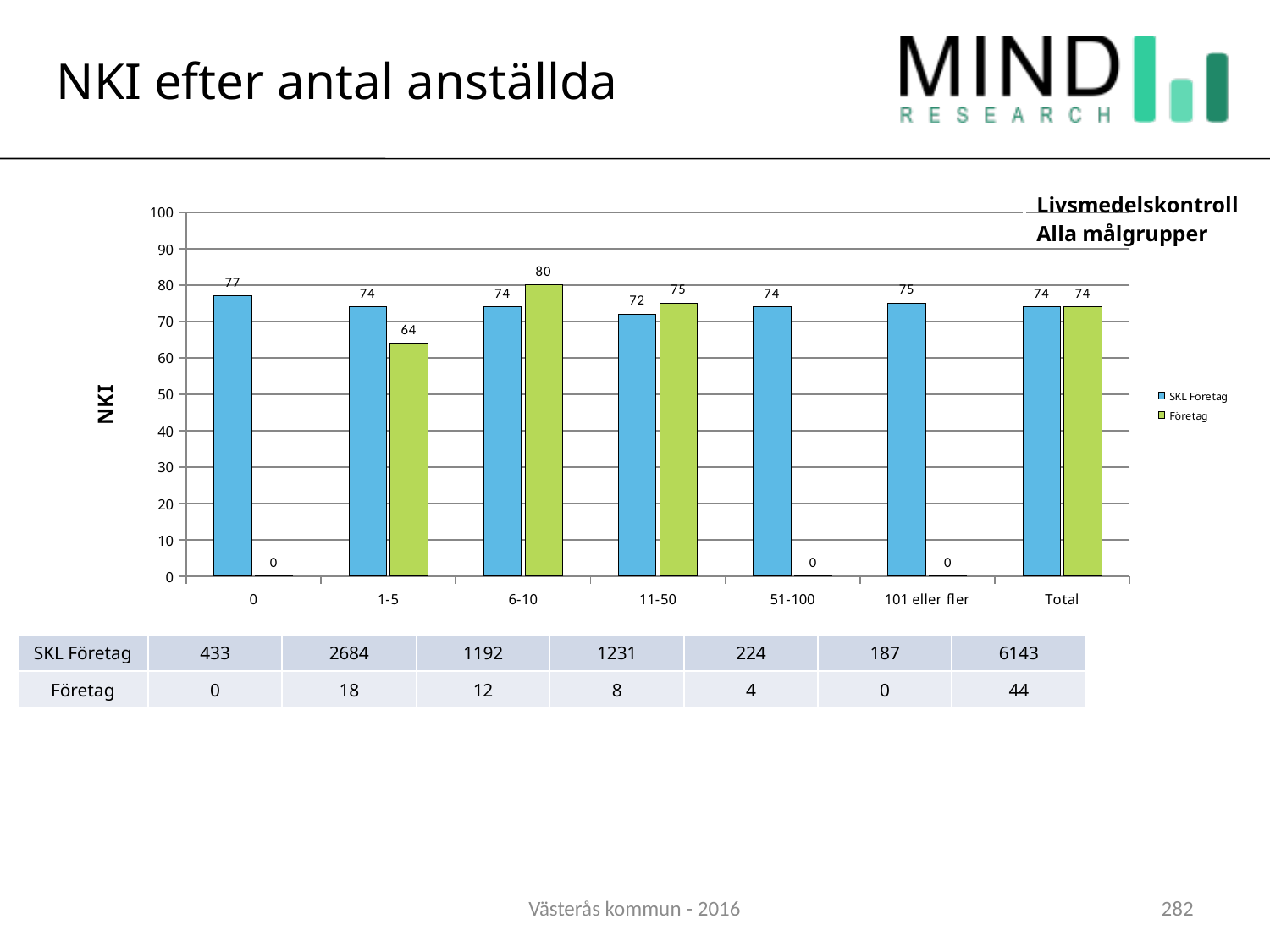
What is the difference between the Företag and SKL Företag values in the 6-10 category? 6 Which category has the lowest NKI value for the SKL Företag series? 11-50 What is the NKI value for SKL Företag in the 0 employees category? 77 What kind of chart is shown on the slide? Bar chart What is the label of the y axis of the chart? NKI Which category has the highest NKI value for the Företag series? 6-10 What is the NKI value for SKL Företag in the 11-50 employees category? 72 What is the NKI value for Företag in the 1-5 employees category? 64 What is the NKI value for Företag in the 6-10 employees category? 80 In the 1-5 category, which series has the larger NKI value, SKL Företag or Företag? SKL Företag How many series does the chart legend list? 2 How many categories are shown on the x axis of the chart? 7